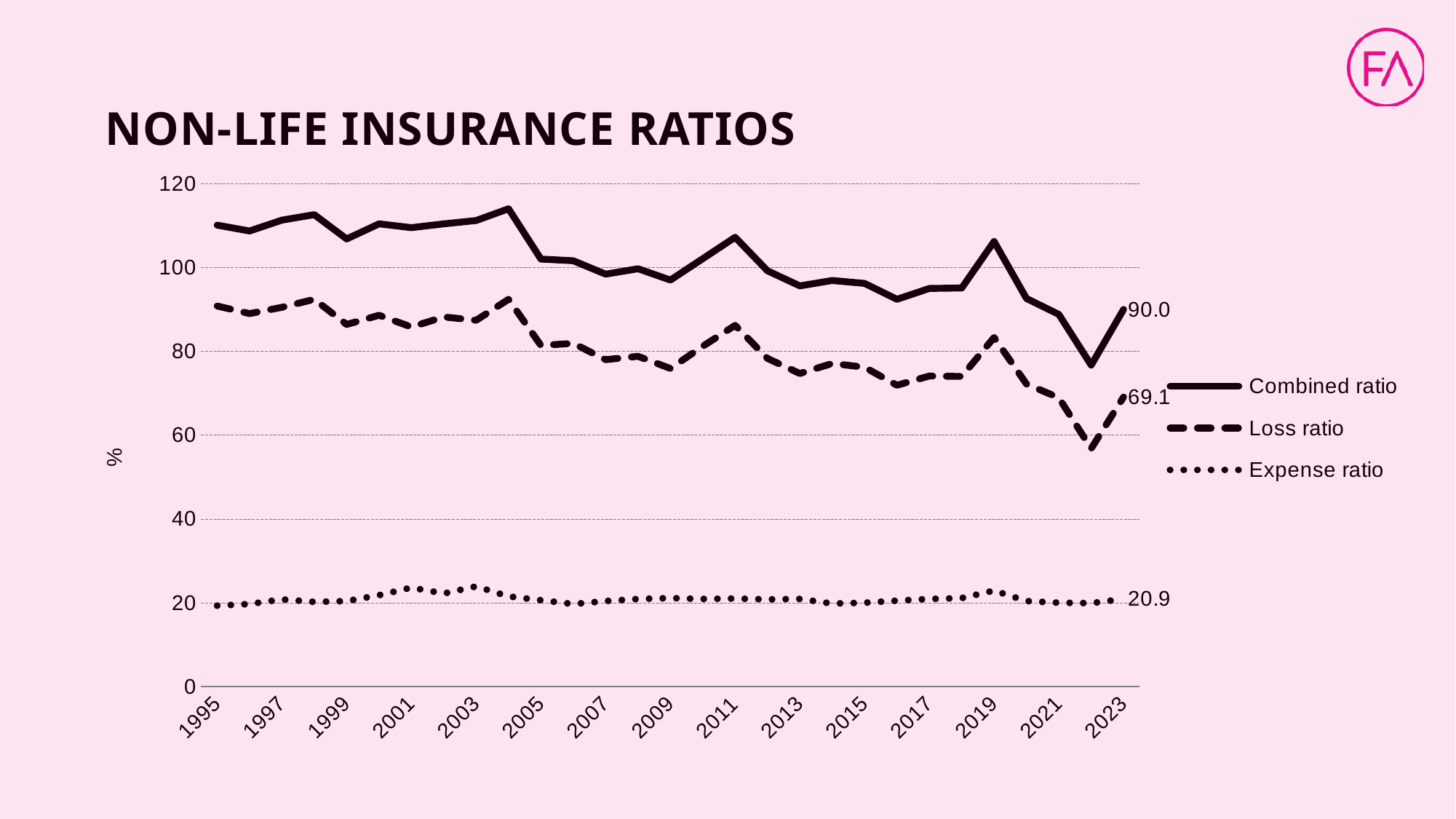
Is the value of the Loss ratio in 2022 greater or less than 60? less What kind of chart is shown on the slide? Line chart Which series has the lowest value in 2023? Expense ratio In 2023, which is larger: the Loss ratio or the Expense ratio? Loss ratio What is the value of the Expense ratio in 2023? 20.9 What is the title of the chart? NON-LIFE INSURANCE RATIOS Is the value of the Combined ratio in 1995 greater or less than 100? greater What is the difference between the Combined ratio and the Loss ratio in 2023? 20.9 What is the value of the Loss ratio in 2023? 69.1 How many series does the legend list? 3 Does the Combined ratio overall rise or fall from 1995 to 2023? Fall What is the value of the Combined ratio in 2023? 90.0